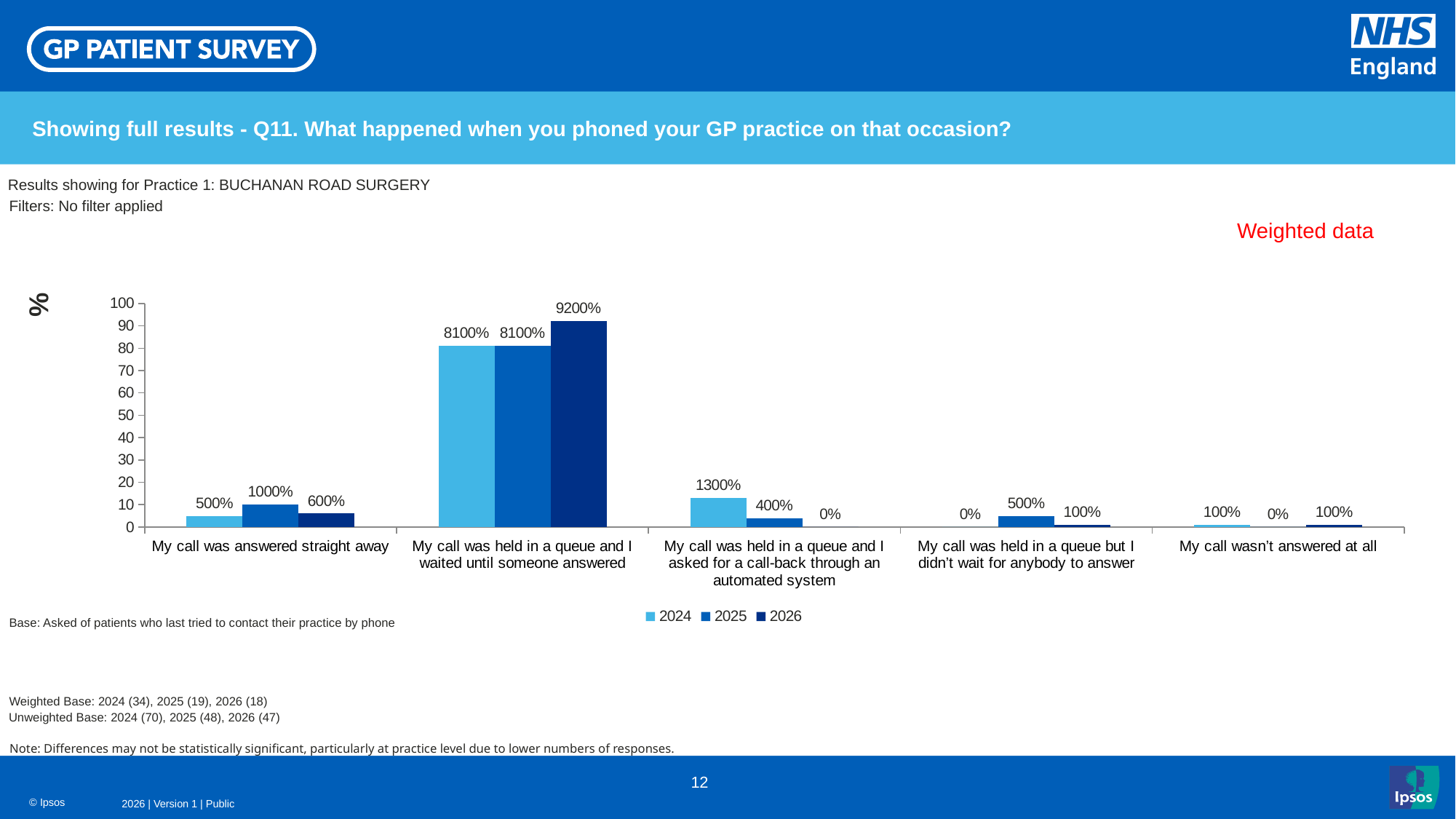
Which category has the highest 2026 value? My call was held in a queue and I waited until someone answered What is the 2026 value for 'My call was held in a queue and I waited until someone answered'? 9200% How many categories are shown on the x axis? 5 What is the 2025 value for 'My call wasn't answered at all'? 0% Which practice are the results shown for? Practice 1: BUCHANAN ROAD SURGERY How many series does the legend list? 3 For 'My call was answered straight away', which year has the larger value, 2024 or 2026? 2026 What is the 2025 value for 'My call was answered straight away'? 1000% What is the 2024 value for 'My call was held in a queue and I asked for a call-back through an automated system'? 1300% Which category has the lowest 2024 value? My call was held in a queue but I didn't wait for anybody to answer What kind of chart is shown on the slide? Bar chart What is the difference between the 2026 and 2024 values for 'My call was held in a queue and I waited until someone answered'? 1100%